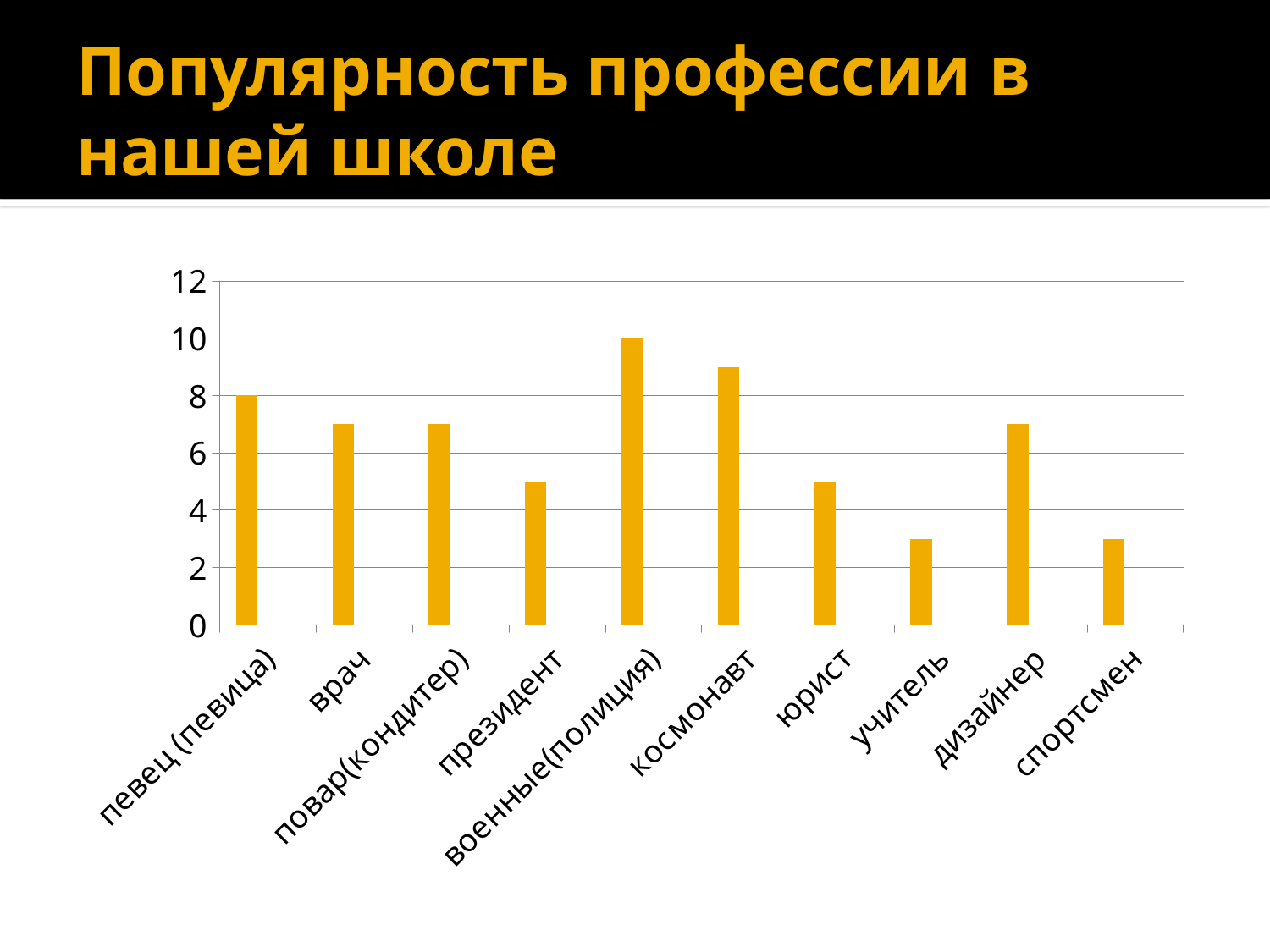
Which is larger, the value for космонавт or the value for юрист? космонавт Is the value for врач greater or less than 6? greater What is the value for военные(полиция)? 10 Is the value for космонавт greater or less than 8? greater How many professions are shown on the chart? 10 What is the value for певец (певица)? 8 What is the difference between the values for военные(полиция) and певец (певица)? 2 Is the value for учитель greater or less than 4? less What kind of chart is shown on the slide? bar chart What is the title of the slide? Популярность профессии в нашей школе Which profession has the highest bar? военные(полиция)